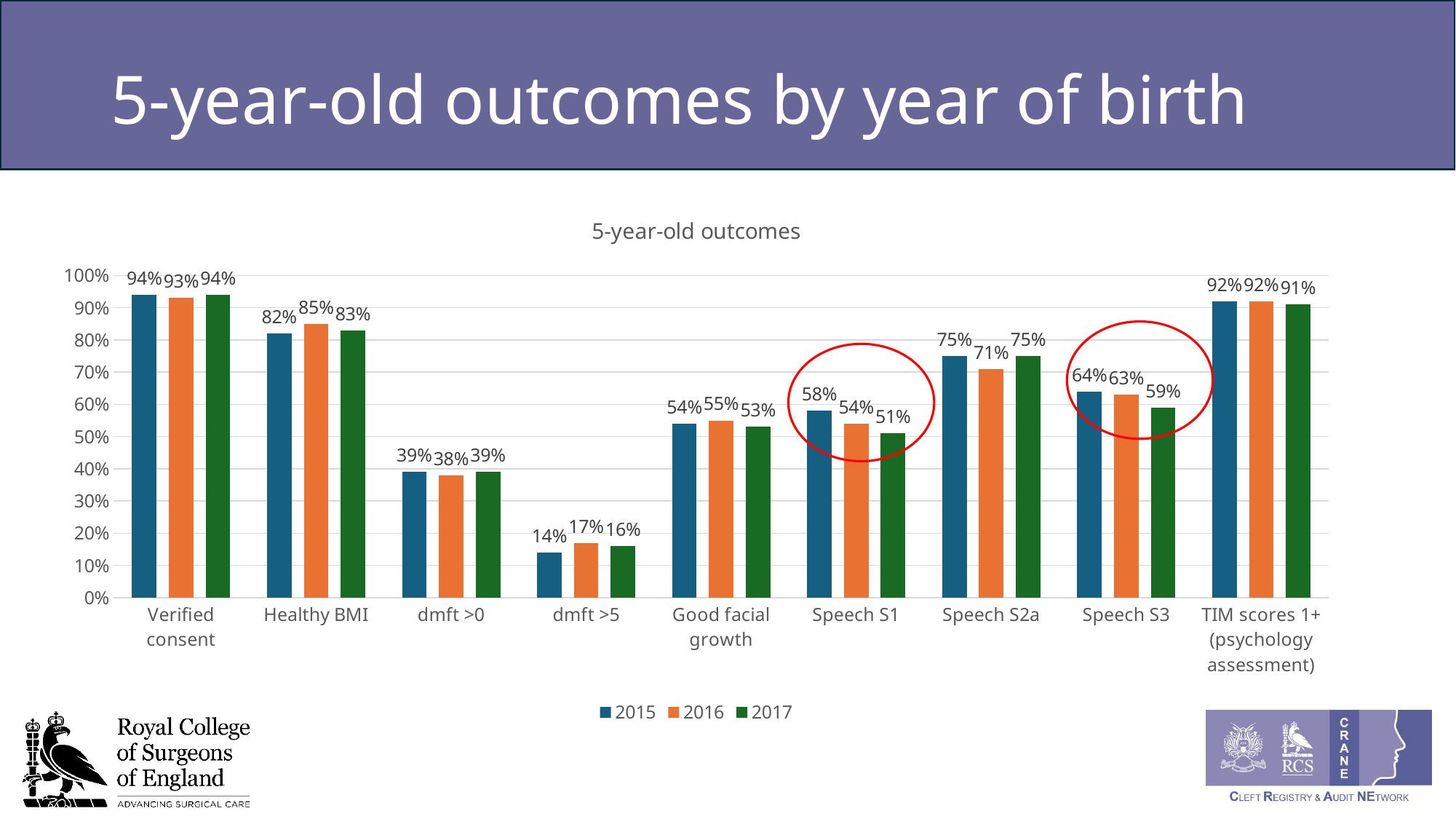
How many categories are shown on the x axis? 9 Which category has the lowest value for 2017? dmft >5 What is the difference between the 2015 and 2017 values for Speech S1? 7% What is the value for dmft >5 in 2015? 14% Which is larger for Speech S2a: the 2015 value or the 2016 value? 2015 What is the title of the chart? 5-year-old outcomes Which category has the highest value for 2016? Verified consent How many series does the legend list? 3 What is the value for Healthy BMI in 2016? 85% What is the value for Speech S1 in 2017? 51% What kind of chart is shown on the slide? Bar chart Which two categories are circled in red on the chart? Speech S1 and Speech S3